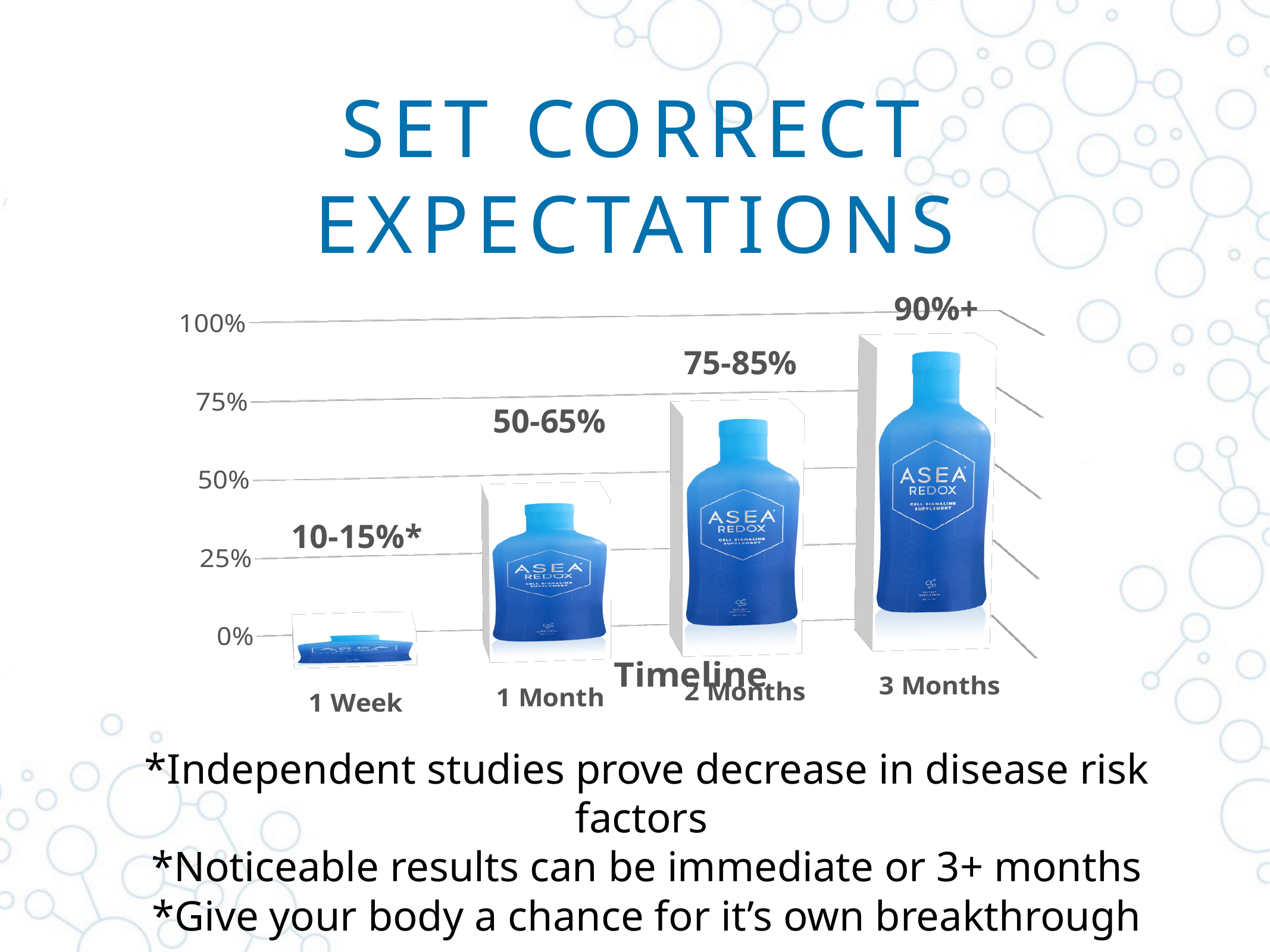
Which is larger, the value for 1 Month or the value for 2 Months? 2 Months Do the values rise or fall from 1 Week to 3 Months? Rise How many categories are shown on the x axis of the chart? 4 Which timeline category has the lowest value? 1 Week What kind of chart is shown on the slide? Bar chart What is the data label shown for 1 Month? 50-65% Is the value for 1 Week greater or less than 25%? less What is the title of the x axis of the chart? Timeline What is the data label shown for 1 Week? 10-15%* Which timeline category has the highest value? 3 Months What is the data label shown for 2 Months? 75-85% What is the data label shown for 3 Months? 90%+